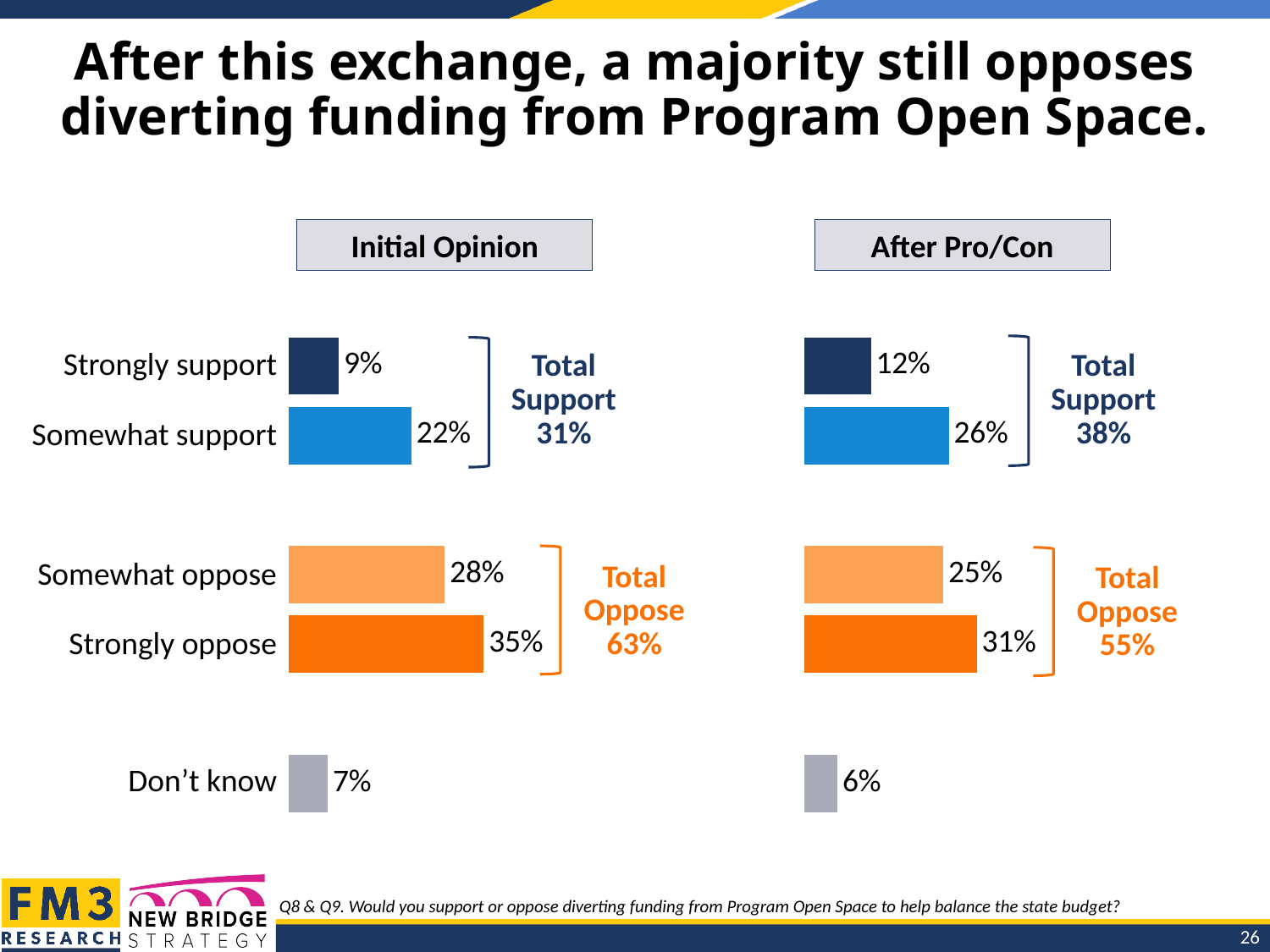
What is the Total Support shown for the Initial Opinion chart? 31% What is the Total Oppose shown for the After Pro/Con chart? 55% In the Initial Opinion chart, what percentage strongly oppose? 35% What is the difference between Strongly oppose in the Initial Opinion chart and Strongly oppose in the After Pro/Con chart? 4% In the After Pro/Con chart, what percentage somewhat support? 26% In the Initial Opinion chart, which is larger: Somewhat support or Somewhat oppose? Somewhat oppose What is the difference between Total Support in the After Pro/Con chart and Total Support in the Initial Opinion chart? 7% How many categories are shown in the After Pro/Con chart? 5 In the After Pro/Con chart, which category has the lowest value? Don't know In the After Pro/Con chart, what is the value for Don't know? 6% What kind of chart is the Initial Opinion chart? Bar chart In the Initial Opinion chart, which category has the highest value? Strongly oppose